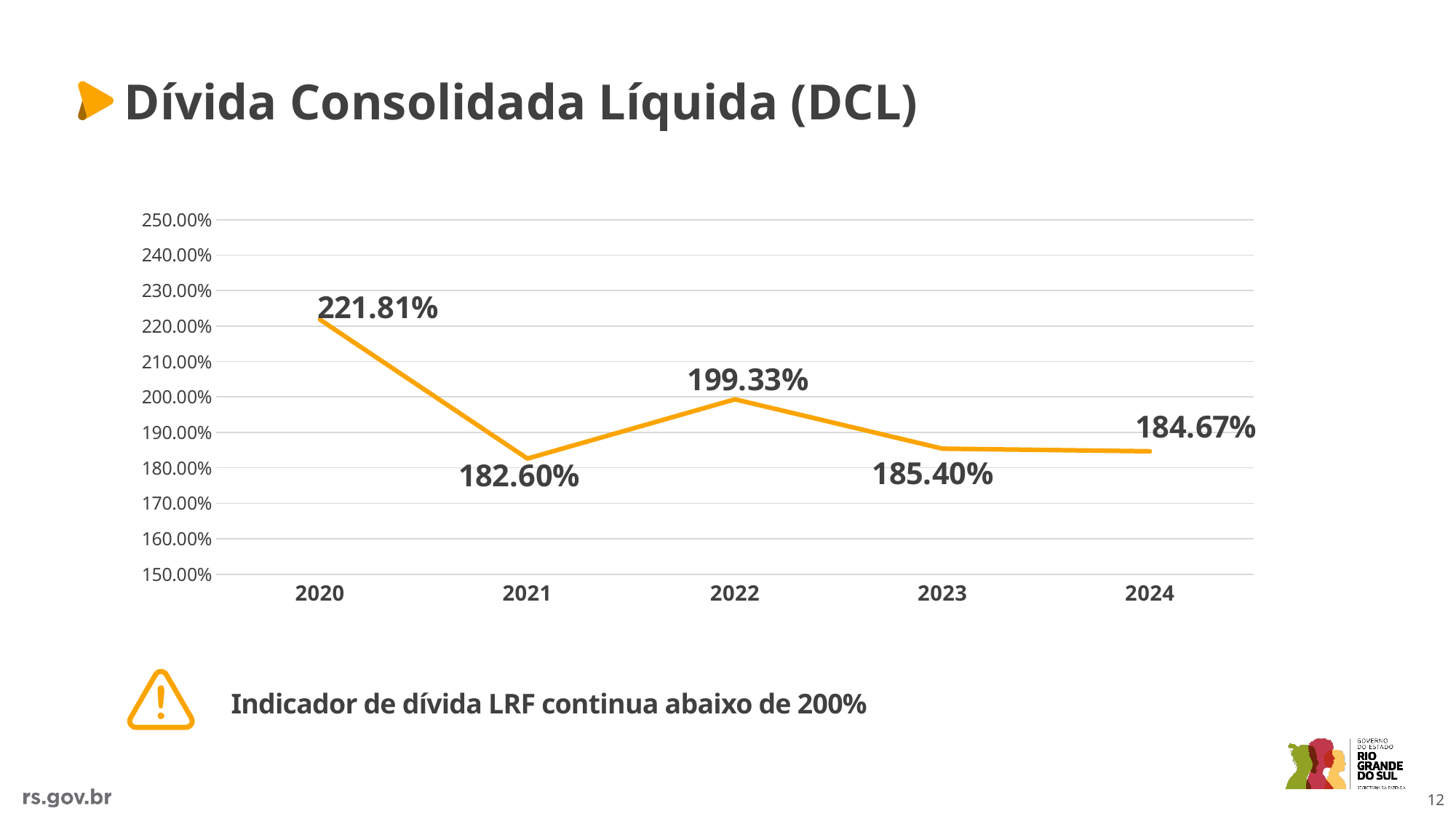
Which is larger, the value for 2022 or the value for 2024? 2022 What is the difference between the values for 2022 and 2023? 13.93% What is the value for 2024? 184.67% What is the value for 2022? 199.33% What kind of chart is shown on the slide? line chart Which year has the lowest value? 2021 What is the difference between the values for 2020 and 2021? 39.21% Is the value for 2021 greater or less than 200.00%? less What is the value for 2020? 221.81% Does the value rise or fall from 2020 to 2021? fall How many years are plotted on the chart? 5 Which year has the highest value? 2020